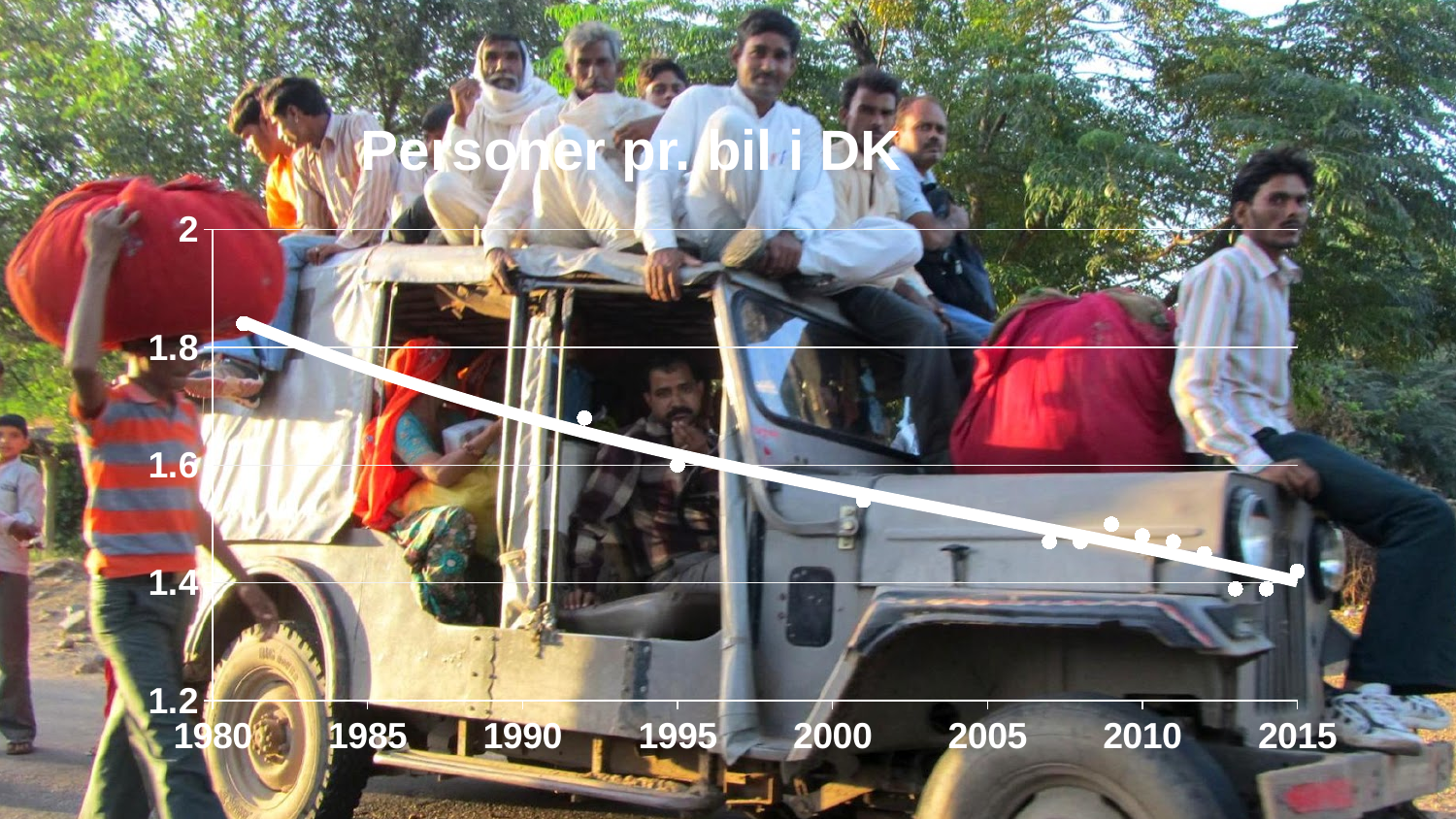
Do the values rise or fall from 1980 to 2015? Fall Which point has the highest value, the one around 1981 or the one around 2015? Around 1981 What is the lowest value shown on the y axis? 1.2 Is the value for the earliest point (around 1981) greater or less than 1.8? greater What kind of chart is shown on the slide? Scatter chart with a trend line Which year's point has the highest value on the chart? Around 1981 Is the value for the point around 2001 greater or less than 1.4? greater Is the value for the point around 2010 greater or less than 1.6? less What is the title of the chart? Personer pr. bil i DK